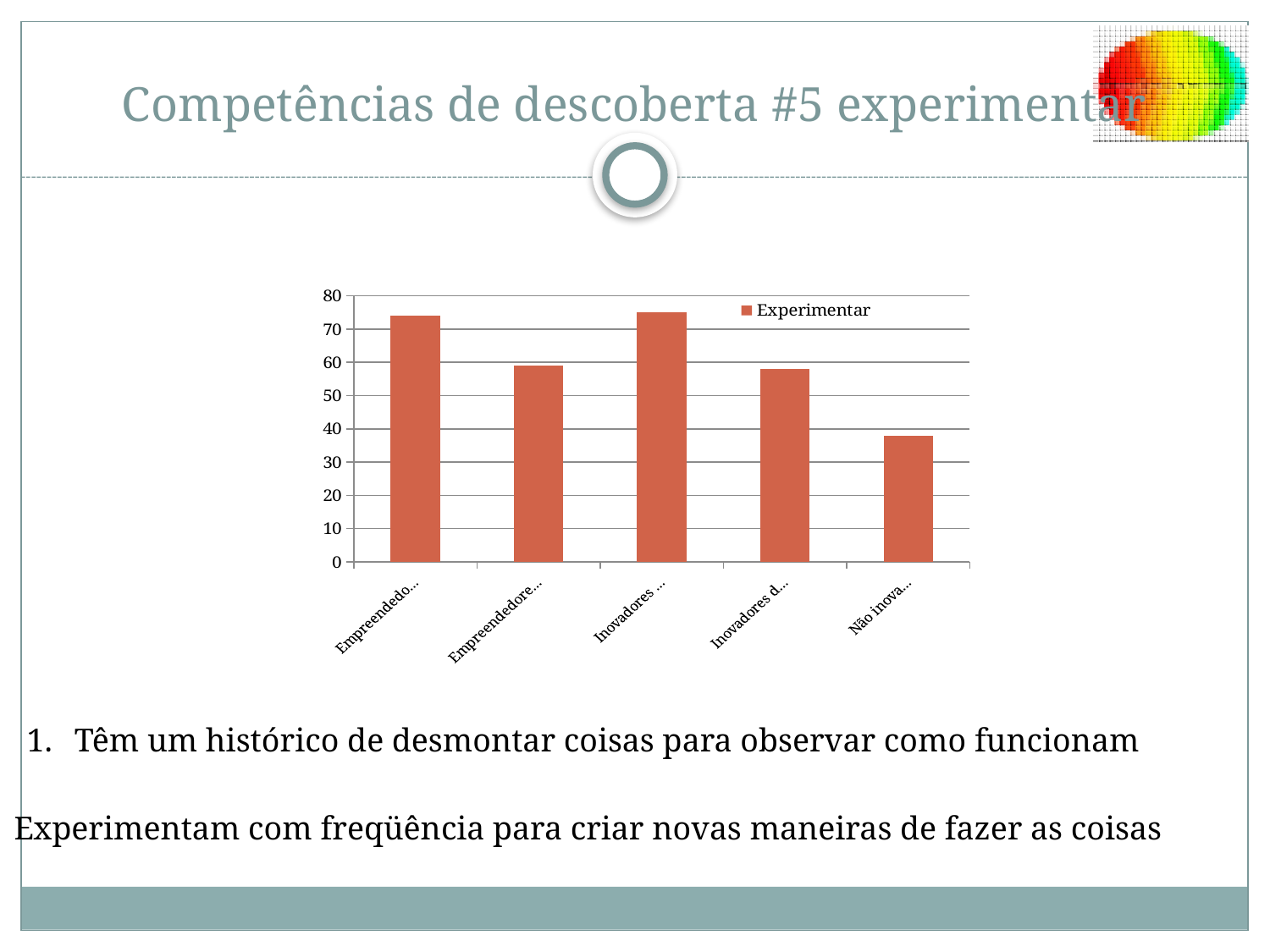
Which is larger, the first bar or the second bar? the first bar How many bars (categories) does the chart show? 5 Is the value of the last bar (Não inova...) greater or less than 50? less Is the value of the second bar (Empreendedore...) greater or less than 50? greater How many series does the chart's legend list? 1 Is the value of the third bar (Inovadores ...) greater or less than 70? greater What is the highest value shown on the chart's vertical axis? 80 Which is larger, the fourth bar or the fifth bar? the fourth bar What kind of chart is shown on the slide? bar chart What is the name of the series shown in the chart's legend? Experimentar Which bar is the lowest in the chart? the last bar (Não inova...)